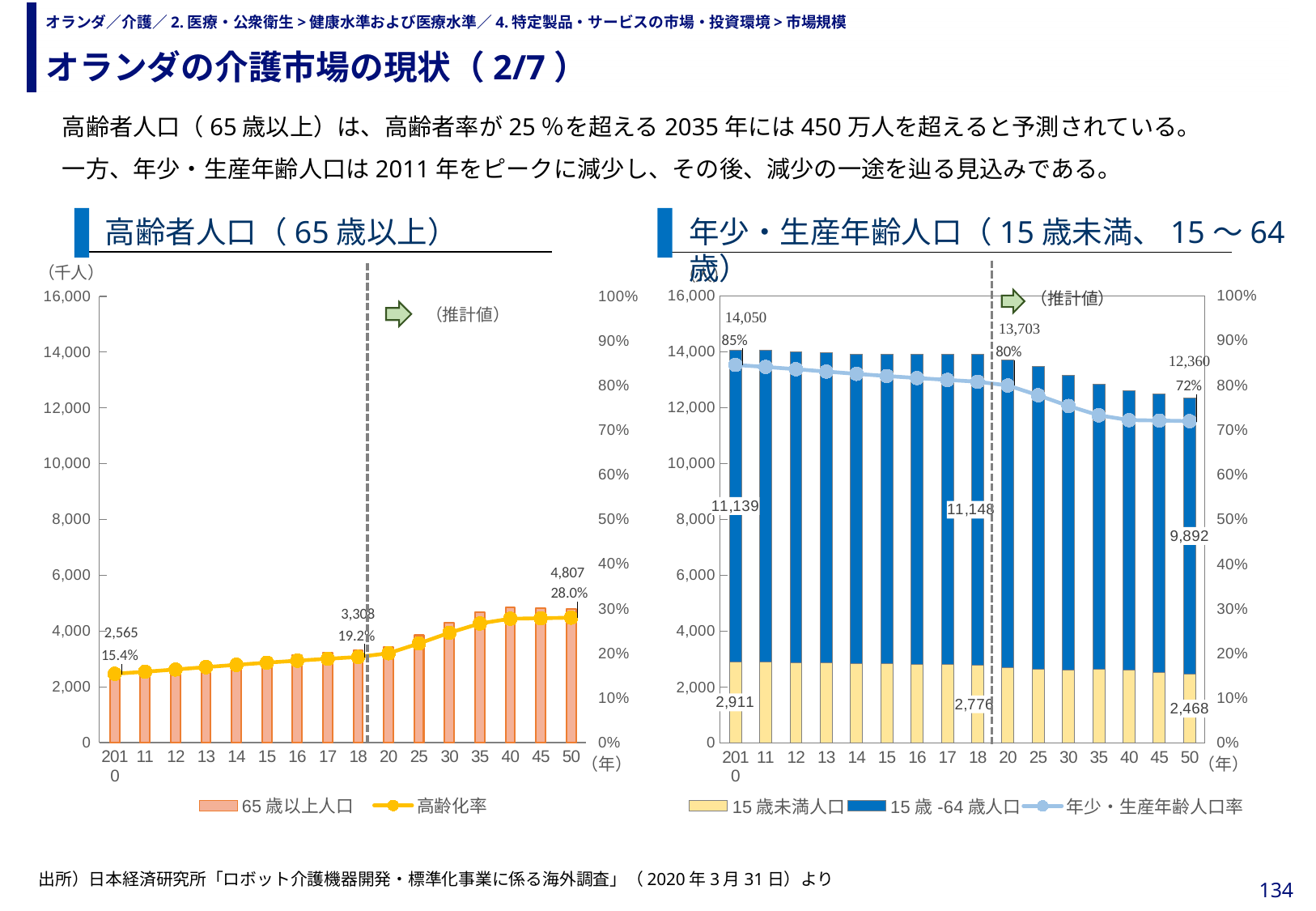
In the left chart (高齢者人口（65歳以上）), what is the 65歳以上人口 value labelled for 2050? 4,807 How many series does the legend of the left chart (高齢者人口（65歳以上）) list? 2 In the left chart (高齢者人口（65歳以上）), by how much does the labelled 65歳以上人口 in 2050 exceed the labelled value in 2010? 2,242 In the left chart (高齢者人口（65歳以上）), what is the 高齢化率 labelled for 2010? 15.4% In the left chart (高齢者人口（65歳以上）), does the 高齢化率 line rise or fall from 2010 to 2050? rise In the right chart (年少・生産年齢人口), what is the difference between the labelled 15歳未満人口 in 2010 and in 2050? 443 In the right chart (年少・生産年齢人口), what is the 15歳-64歳人口 value labelled for 2050? 9,892 How many series does the legend of the right chart (年少・生産年齢人口) list? 3 How many years are shown on the x axis of the left chart (高齢者人口（65歳以上）)? 16 In the right chart (年少・生産年齢人口), what is the total of the stacked bar for 2010? 14,050 In the left chart (高齢者人口（65歳以上）), is the 65歳以上人口 bar for 2040 greater or less than 4,000? greater